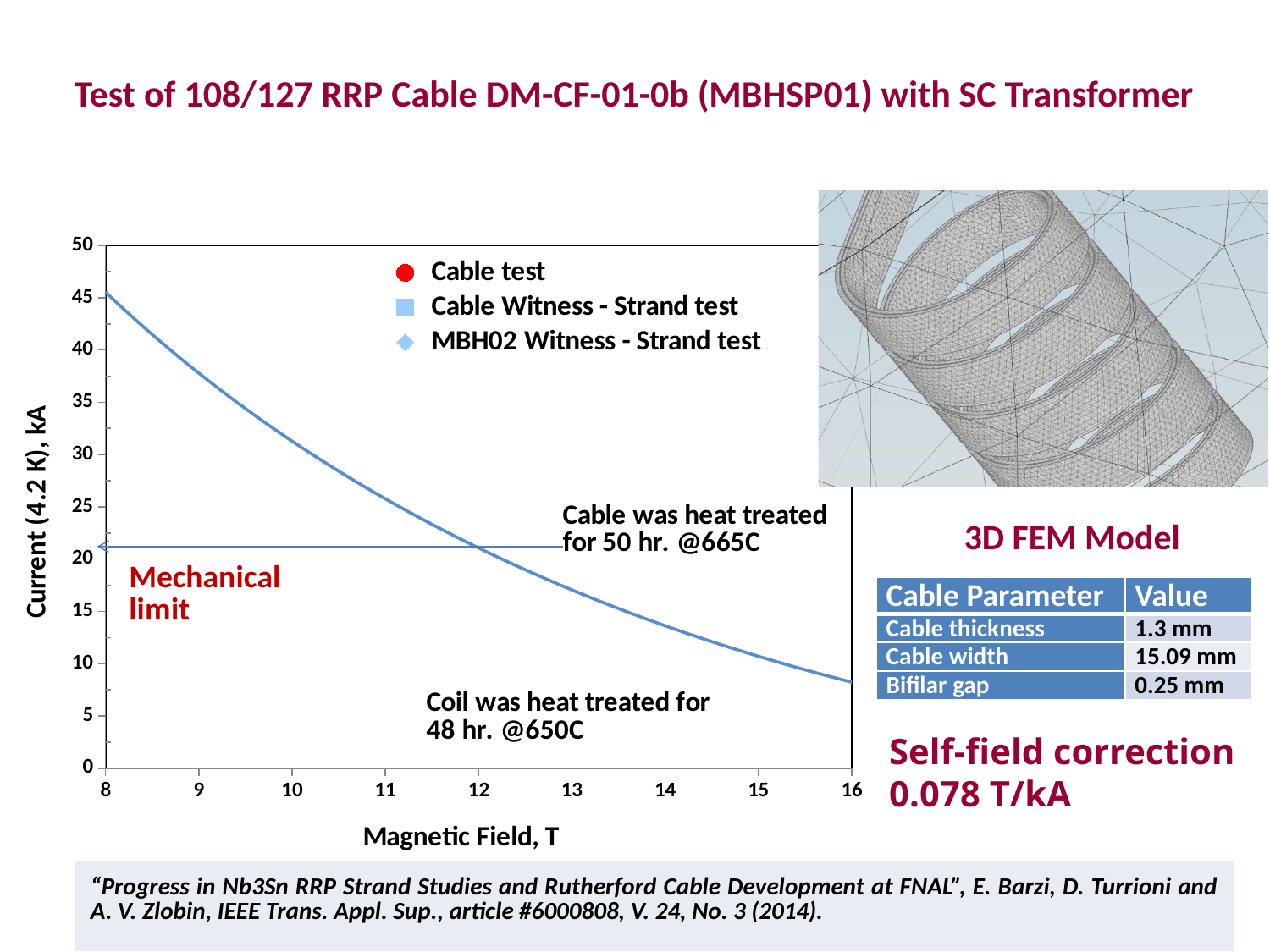
What is the label of the chart's y axis? Current (4.2 K), kA Is the current at a magnetic field of 13 T greater or less than 20 kA? less Is the current at a magnetic field of 16 T greater or less than 10 kA? less Is the current at a magnetic field of 8 T greater or less than 40 kA? greater Is the current at 9 T greater or less than the current at 14 T? greater How many tick labels are shown on the x axis of the chart? 9 What is the label of the chart's x axis? Magnetic Field, T What kind of chart is shown on the slide? line chart How many series does the chart legend list? 3 Does the plotted current rise or fall as the magnetic field increases from 8 T to 16 T? fall